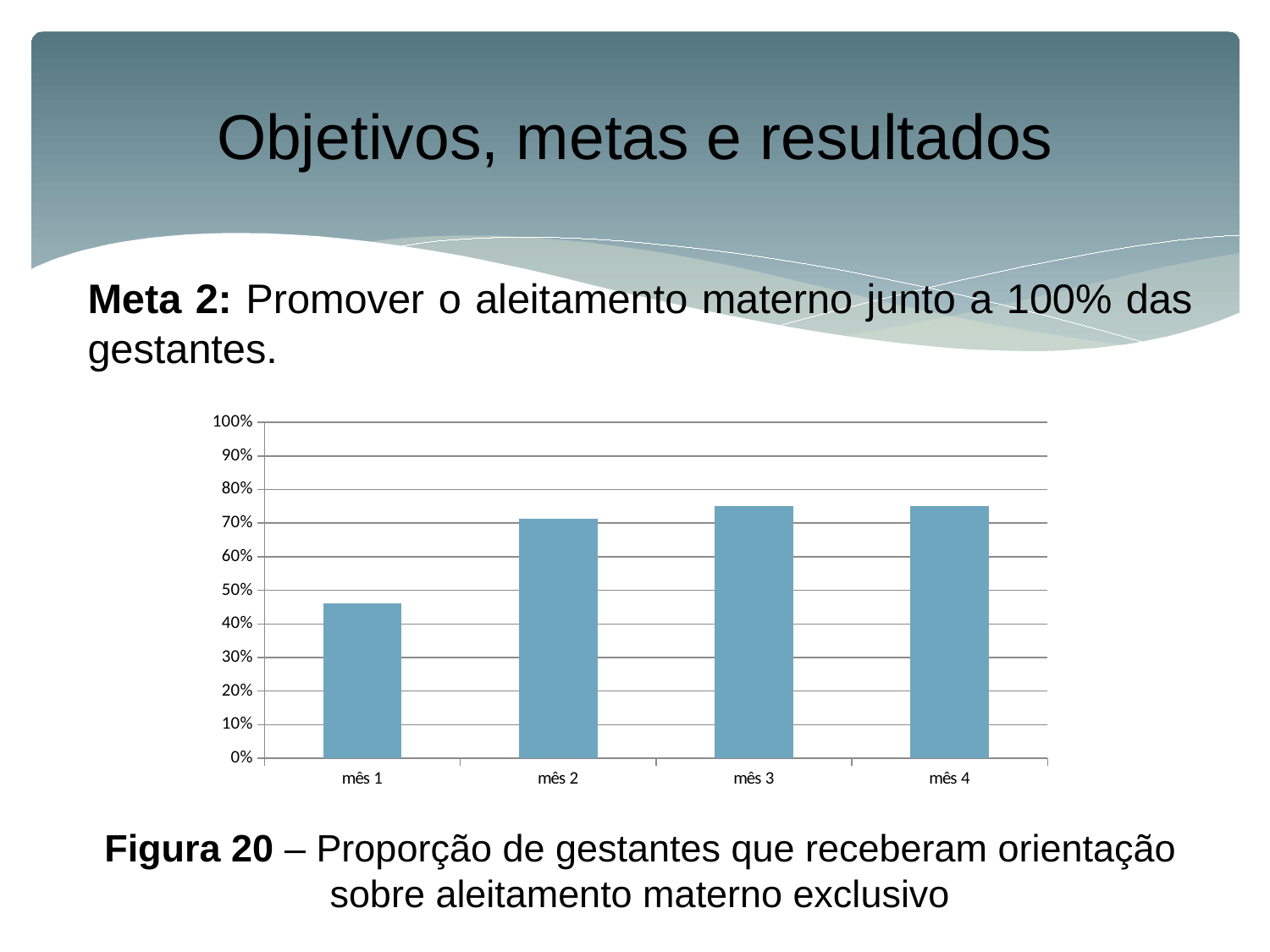
Is the value for mês 2 greater or less than 60%? greater What kind of chart is shown on the slide? bar chart What is the figure number given in the caption below the chart? Figura 20 How many categories (months) are shown on the x axis of the chart? 4 Which is larger, the value for mês 1 or the value for mês 2? mês 2 Which month has the lowest bar in the chart? mês 1 Is the value for mês 4 greater or less than 70%? greater Is the value for mês 1 greater or less than 50%? less Do the values generally rise or fall from mês 1 to mês 4? rise What is the highest value shown on the y axis of the chart? 100%